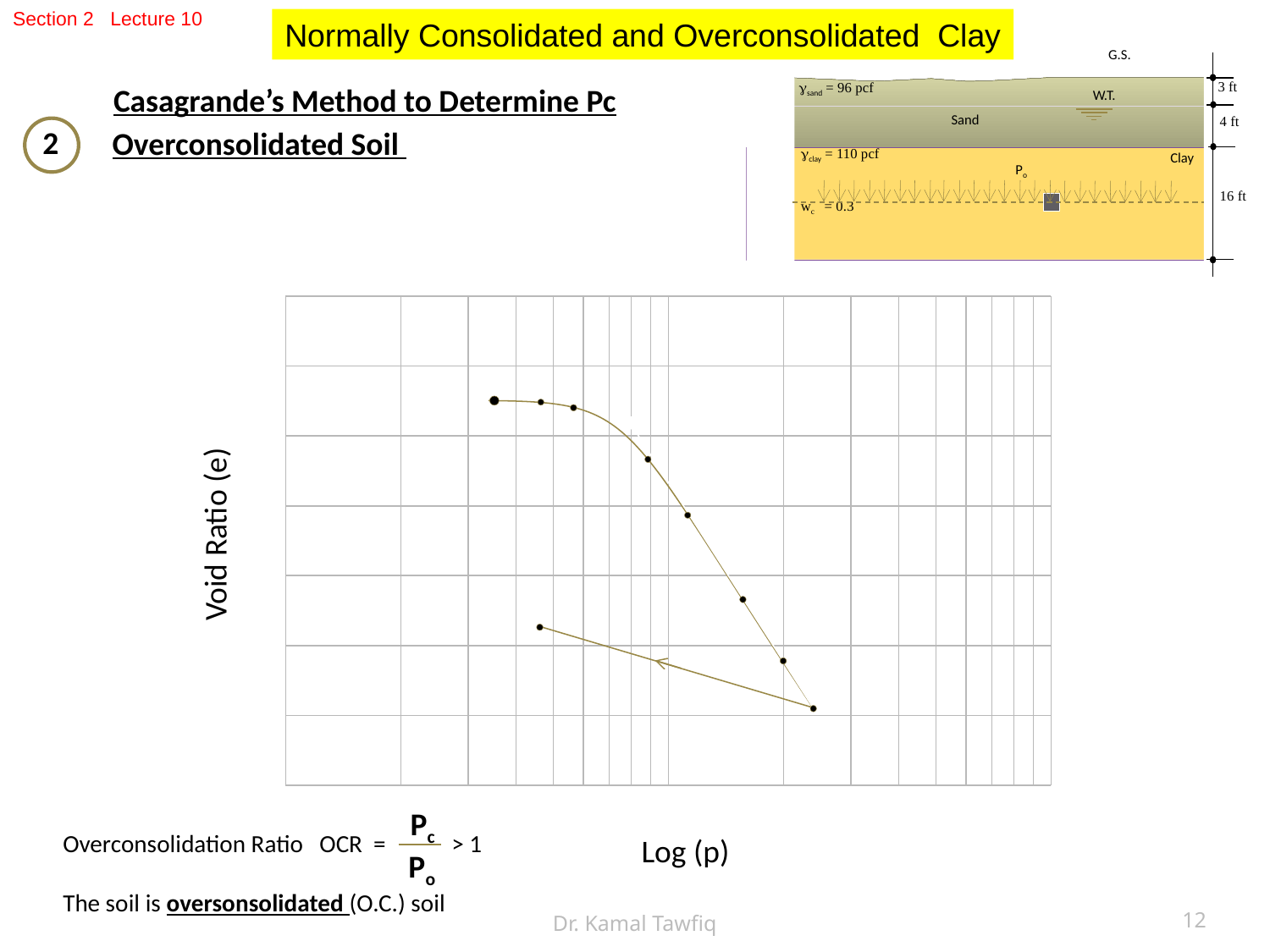
Does the chart show any numeric tick values on its axes? No What kind of chart is shown on the slide? line chart What is the label on the horizontal axis of the chart? Log (p) What is the label on the vertical axis of the chart? Void Ratio (e) How many data points are plotted on the chart? 9 Along the main curve, does the void ratio rise or fall as Log (p) increases? fall